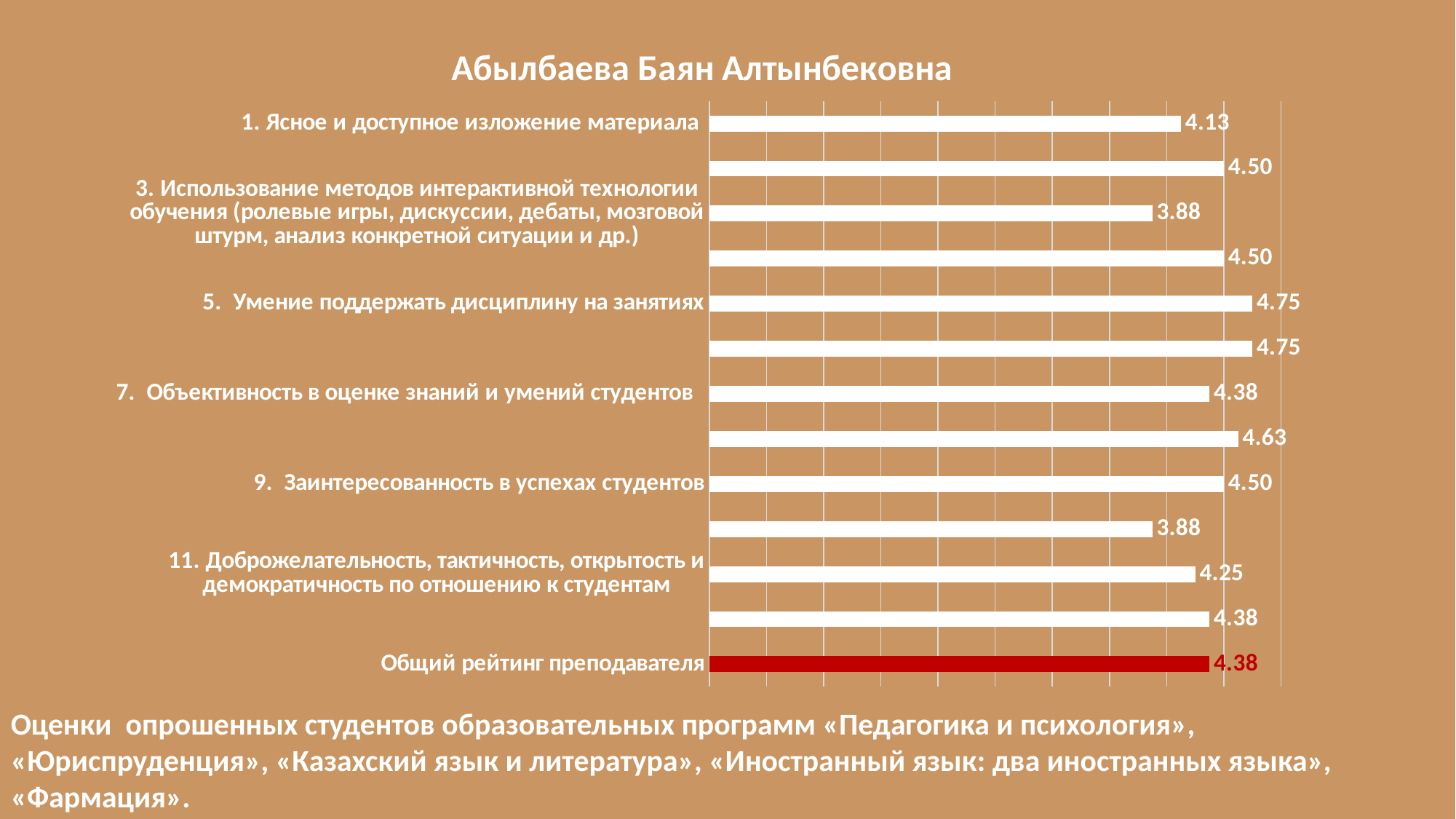
What is the highest value shown on the chart? 4.75 What is the value for "5. Умение поддержать дисциплину на занятиях"? 4.75 Which has a larger value: "9. Заинтересованность в успехах студентов" or "11. Доброжелательность, тактичность, открытость и демократичность по отношению к студентам"? 9. Заинтересованность в успехах студентов How many bars are plotted on the chart? 13 What is the value for "Общий рейтинг преподавателя"? 4.38 What is the value for "7. Объективность в оценке знаний и умений студентов"? 4.38 What is the lowest value shown on the chart? 3.88 What is the value for "9. Заинтересованность в успехах студентов"? 4.50 What kind of chart is shown on the slide? Bar chart What is the difference between the value for "5. Умение поддержать дисциплину на занятиях" and the value for "1. Ясное и доступное изложение материала"? 0.62 What is the value for "11. Доброжелательность, тактичность, открытость и демократичность по отношению к студентам"? 4.25 What is the value for "1. Ясное и доступное изложение материала"? 4.13